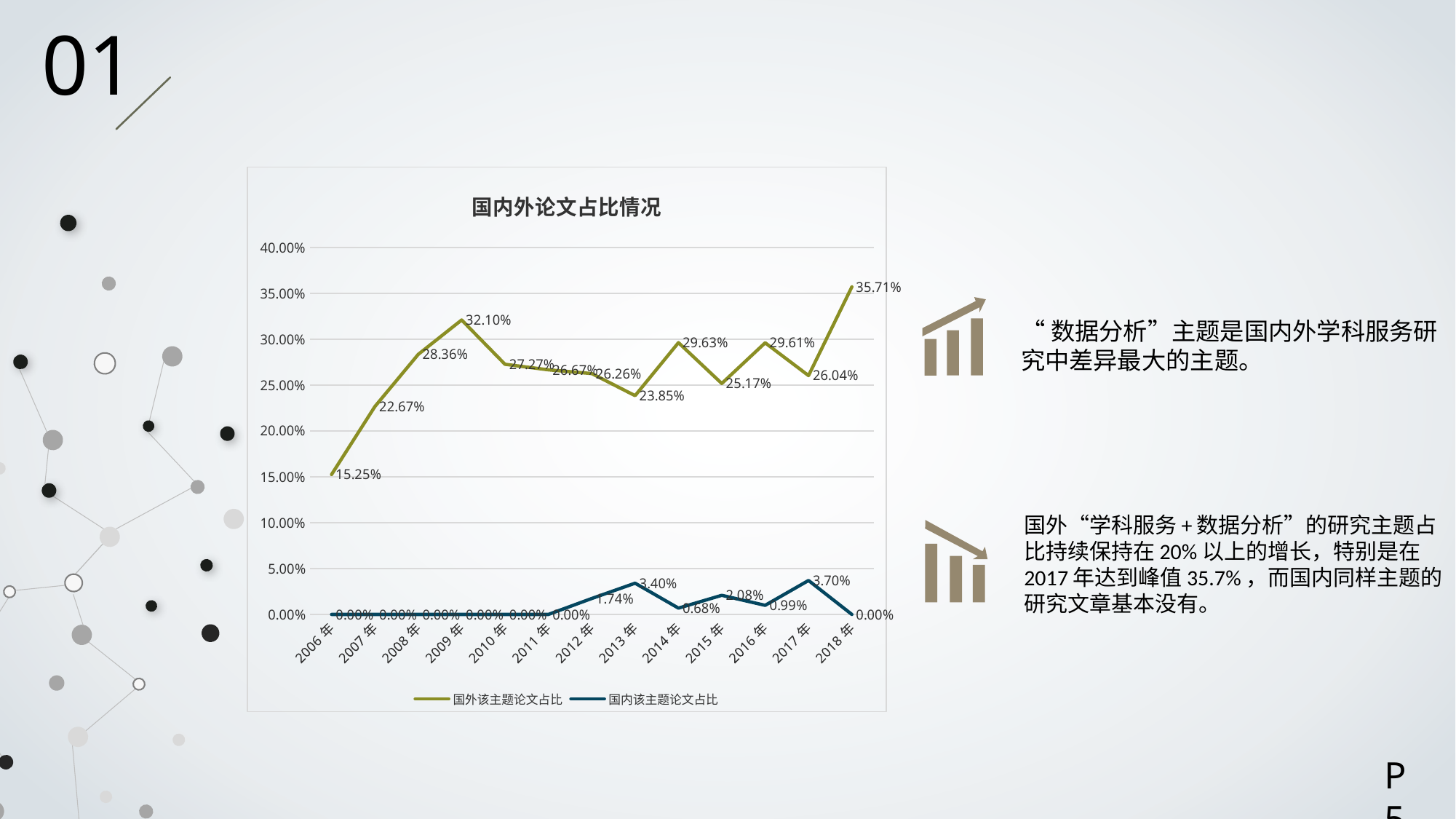
What is the difference between 国外该主题论文占比 in 2009年 and 2006年? 16.85% How many series does the legend list? 2 What is the value of 国内该主题论文占比 in 2013年? 3.40% In which year is 国外该主题论文占比 the highest? 2018年 In which year is 国外该主题论文占比 the lowest? 2006年 What is the value of 国内该主题论文占比 in 2017年? 3.70% What is the title of the chart? 国内外论文占比情况 Which is larger, 国外该主题论文占比 in 2014年 or in 2015年? 2014年 What is the value of 国外该主题论文占比 in 2018年? 35.71% What type of chart is shown on the slide? line chart Is the value of 国外该主题论文占比 in 2013年 greater or less than 25.00%? less How many years are shown on the x axis? 13